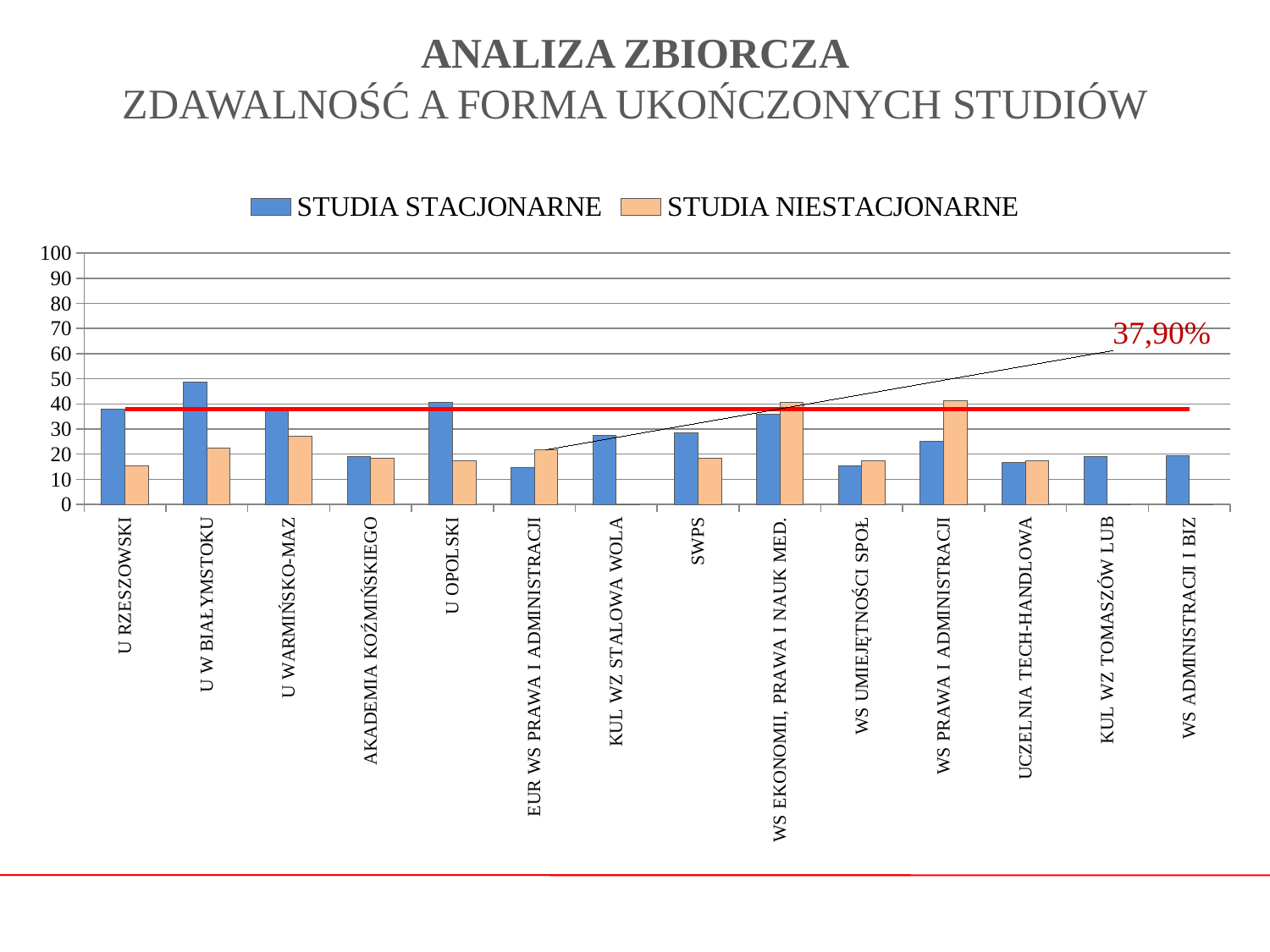
What kind of chart is shown on the slide? bar chart Which institution has the highest value for STUDIA STACJONARNE? U W BIAŁYMSTOKU Is the STUDIA NIESTACJONARNE value for U OPOLSKI greater or less than 20? less What value is labelled on the red horizontal line across the chart? 37,90% Is the STUDIA STACJONARNE value for KUL WZ STALOWA WOLA greater or less than 20? greater How many institutions (categories) are shown on the x axis? 14 Is the STUDIA STACJONARNE value for U W BIAŁYMSTOKU greater or less than 40? greater For U RZESZOWSKI, which is larger: STUDIA STACJONARNE or STUDIA NIESTACJONARNE? STUDIA STACJONARNE For WS PRAWA I ADMINISTRACJI, which is larger: STUDIA STACJONARNE or STUDIA NIESTACJONARNE? STUDIA NIESTACJONARNE Which series is shown in blue in the legend? STUDIA STACJONARNE How many series does the legend list? 2